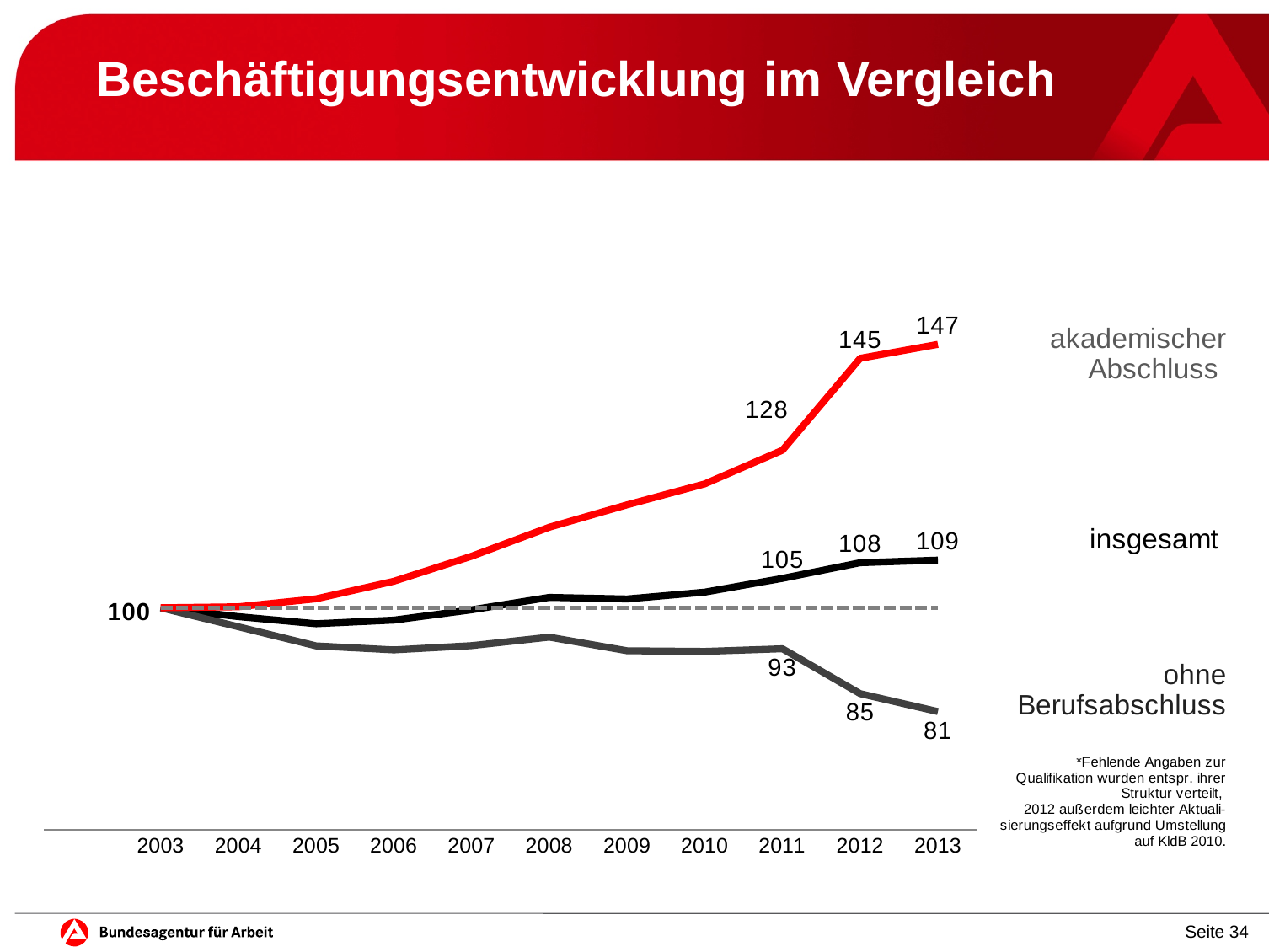
Which series has the highest value in 2013? akademischer Abschluss How many years are shown on the x axis? 11 What is the value for akademischer Abschluss in 2013? 147 What is the difference between akademischer Abschluss and insgesamt in 2013? 38 Which series has the lowest value in 2013? ohne Berufsabschluss What kind of chart is shown on the slide? line chart What is the value for akademischer Abschluss in 2011? 128 Does the akademischer Abschluss line rise or fall from 2003 to 2013? rise Which is larger in 2012: insgesamt or ohne Berufsabschluss? insgesamt What is the value for ohne Berufsabschluss in 2012? 85 What is the difference between the 2012 and 2013 values for ohne Berufsabschluss? 4 What is the value for insgesamt in 2011? 105